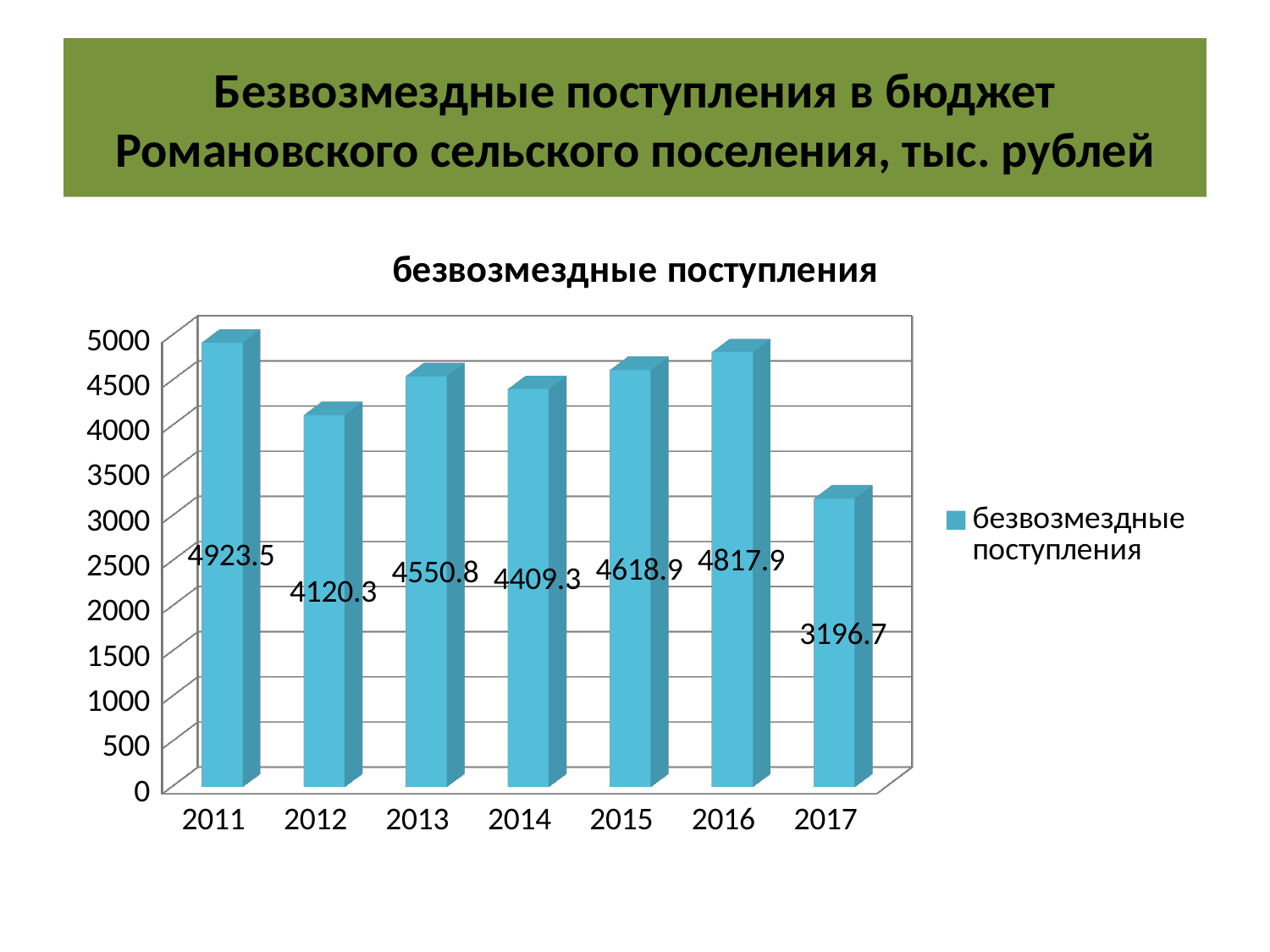
Is the value for 2016 greater or less than 4500? greater Which is larger, the value for 2013 or the value for 2012? 2013 How many years are shown on the x axis? 7 What is the value for 2011? 4923.5 What is the value for 2017? 3196.7 What is the value for 2014? 4409.3 What is the difference between the values for 2011 and 2017? 1726.8 Which year has the lowest value? 2017 What kind of chart is this? bar chart What is the title of the chart? безвозмездные поступления Which year has the highest value? 2011 What is the difference between the values for 2016 and 2015? 199.0